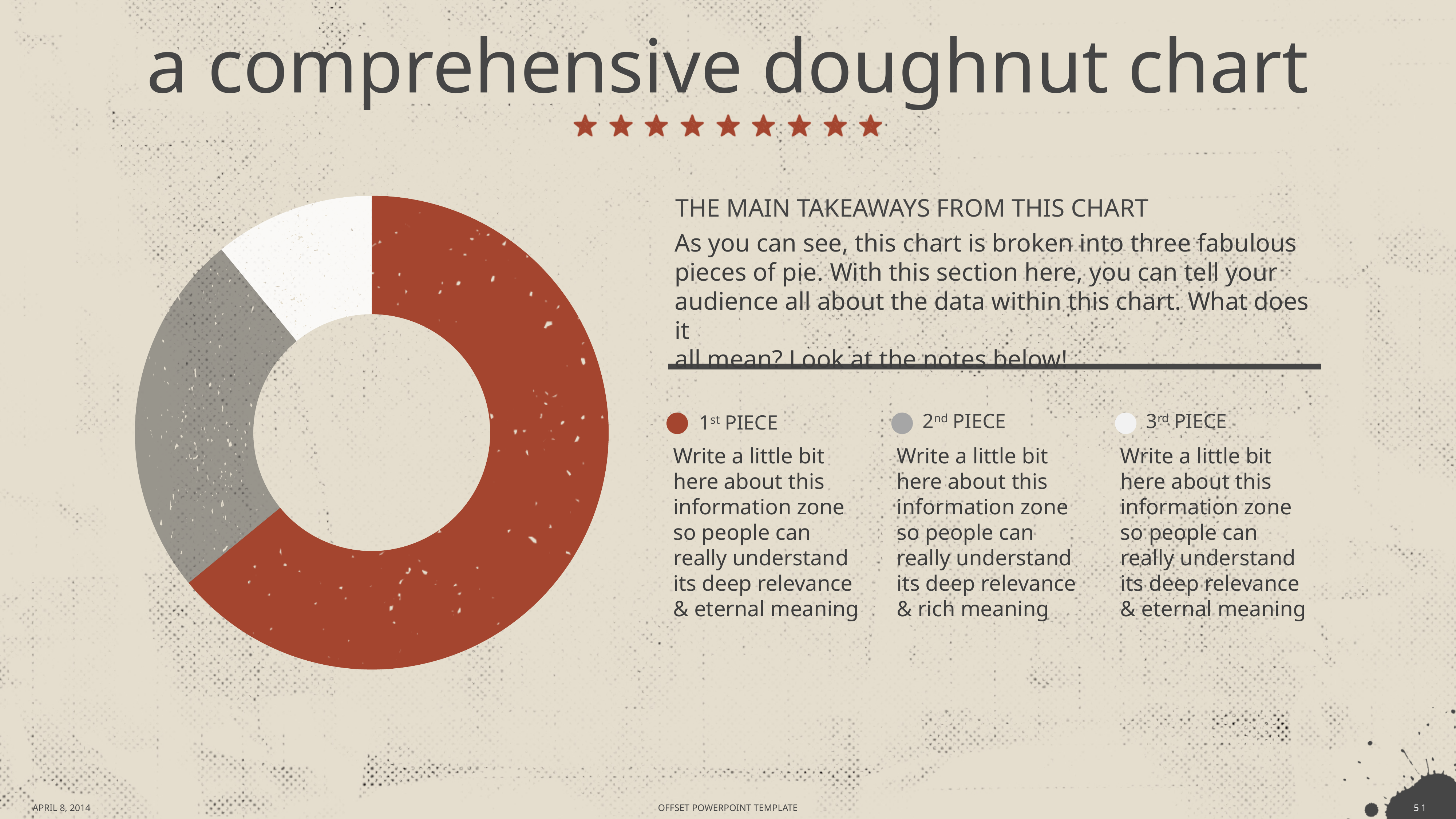
Which piece of the doughnut chart is the smallest? 3rd PIECE Which is larger in the doughnut chart, the 1st PIECE or the 2nd PIECE? 1st PIECE What colour represents the 1st PIECE in the doughnut chart? red What kind of chart is shown on the slide? doughnut chart Which piece of the doughnut chart is the largest? 1st PIECE How many entries does the legend below the takeaways text list? 3 Which is larger in the doughnut chart, the 2nd PIECE or the 3rd PIECE? 2nd PIECE Does the 1st PIECE take up more or less than half of the doughnut chart? more How many pieces is the doughnut chart divided into? 3 What colour represents the 2nd PIECE in the doughnut chart? gray